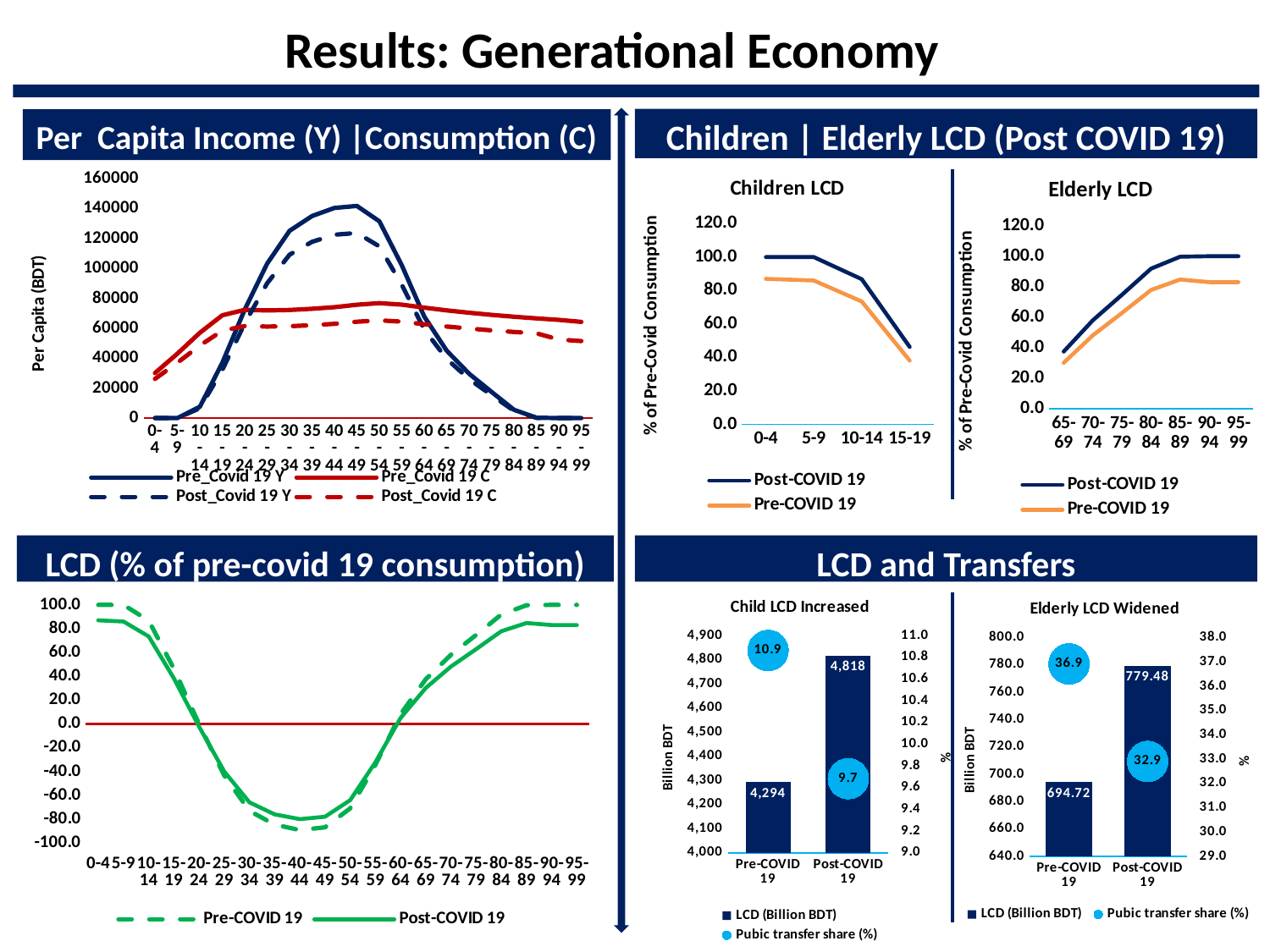
How many series does the legend of the 'Per Capita Income (Y) | Consumption (C)' chart list? 4 In the 'Elderly LCD Widened' chart, what is the public transfer share (%) for Post-COVID 19? 32.9 In the 'Child LCD Increased' chart, what is the LCD (Billion BDT) value for Post-COVID 19? 4,818 In the 'Elderly LCD Widened' chart, what is the LCD (Billion BDT) value for Post-COVID 19? 779.48 In the 'Children LCD' chart, do the Post-COVID 19 values rise or fall from 0-4 to 15-19? fall In the 'Elderly LCD' chart, is the Post-COVID 19 value for 65-69 greater or less than 60.0? less In the 'Elderly LCD Widened' chart, which period has the larger LCD value, Pre-COVID 19 or Post-COVID 19? Post-COVID 19 In the 'Child LCD Increased' chart, what is the difference between the Post-COVID 19 and Pre-COVID 19 LCD values? 524 In the 'Child LCD Increased' chart, what is the public transfer share (%) for Pre-COVID 19? 10.9 In the 'Child LCD Increased' chart, what is the LCD (Billion BDT) value for Pre-COVID 19? 4,294 How many age-group categories are shown on the x axis of the 'Children LCD' chart? 4 What kind of chart is the 'LCD (% of pre-covid 19 consumption)' chart? line chart